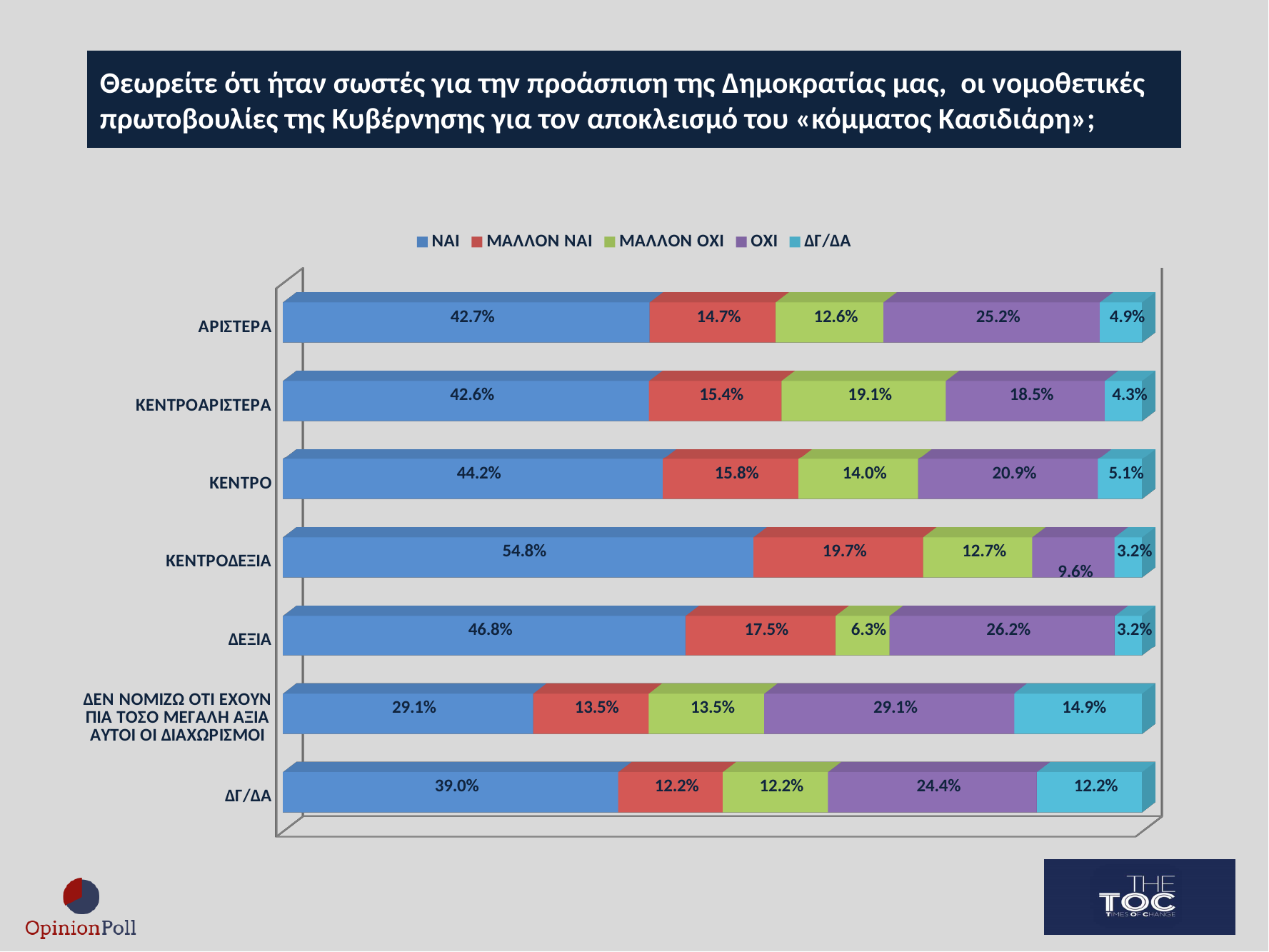
How many categories are shown on the chart? 7 What is the ΝΑΙ value for ΚΕΝΤΡΟ? 44.2% What is the ΟΧΙ value for ΔΕΞΙΑ? 26.2% What is the ΔΓ/ΔΑ value for ΚΕΝΤΡΟΑΡΙΣΤΕΡΑ? 4.3% What is the difference between the ΝΑΙ values for ΚΕΝΤΡΟΔΕΞΙΑ and ΔΕΞΙΑ? 8.0 percentage points Which category has the lowest ΟΧΙ value? ΚΕΝΤΡΟΔΕΞΙΑ Which category has the highest ΔΓ/ΔΑ value? ΔΕΝ ΝΟΜΙΖΩ ΟΤΙ ΕΧΟΥΝ ΠΙΑ ΤΟΣΟ ΜΕΓΑΛΗ ΑΞΙΑ ΑΥΤΟΙ ΟΙ ΔΙΑΧΩΡΙΣΜΟΙ Which category has the highest ΝΑΙ value? ΚΕΝΤΡΟΔΕΞΙΑ How many series does the legend list? 5 What type of chart is shown on the slide? Stacked bar chart What is the total of the stacked bar for ΔΓ/ΔΑ? 100.0% Which has the larger ΜΑΛΛΟΝ ΟΧΙ value, ΚΕΝΤΡΟ or ΚΕΝΤΡΟΑΡΙΣΤΕΡΑ? ΚΕΝΤΡΟΑΡΙΣΤΕΡΑ